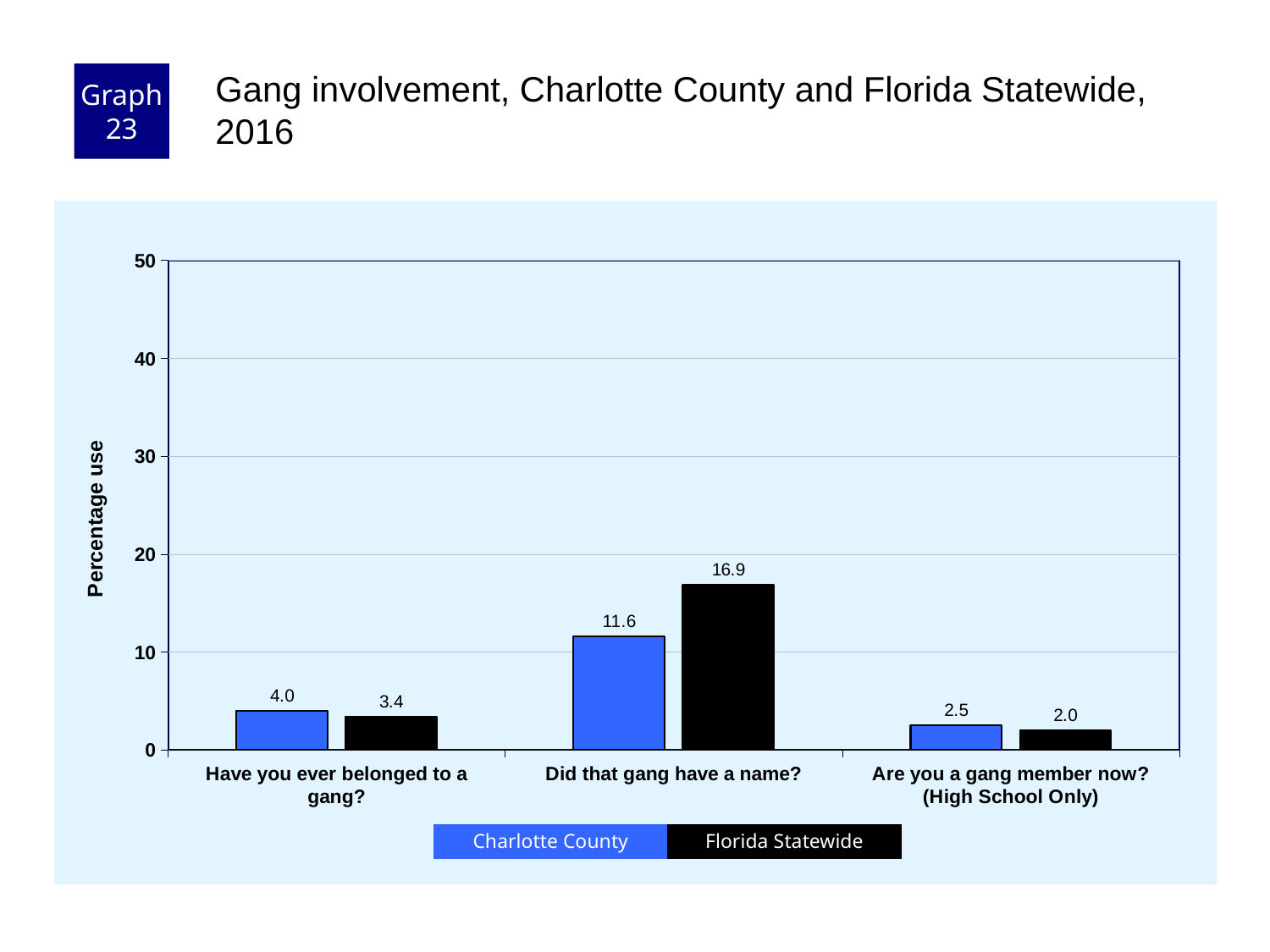
What is the Charlotte County value for "Are you a gang member now? (High School Only)"? 2.5 What kind of chart is shown on the slide? bar chart Which question has the lowest Charlotte County value? Are you a gang member now? (High School Only) For "Are you a gang member now? (High School Only)", which is larger: Charlotte County or Florida Statewide? Charlotte County What is the Florida Statewide value for "Did that gang have a name?"? 16.9 How many series does the legend list? 2 What is the Charlotte County value for "Have you ever belonged to a gang?"? 4.0 Is the Florida Statewide value for "Did that gang have a name?" greater or less than 20? less What is the difference between the Florida Statewide and Charlotte County values for "Did that gang have a name?"? 5.3 Which question has the highest Florida Statewide value? Did that gang have a name? How many question categories are shown on the x axis? 3 What is the Florida Statewide value for "Have you ever belonged to a gang?"? 3.4